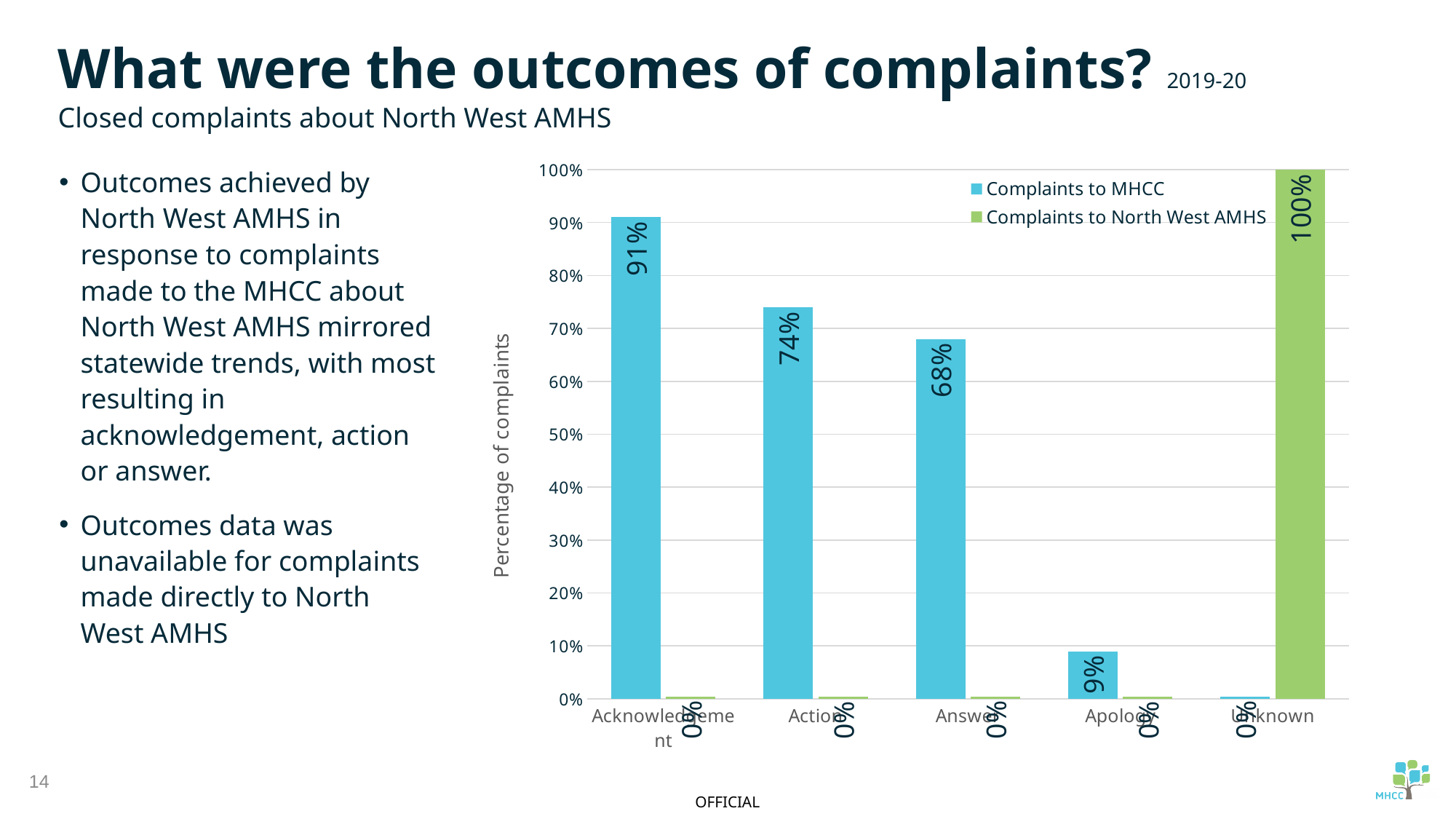
What percentage of complaints to MHCC resulted in Answer? 68% How many outcome categories are shown on the x axis? 5 How many series does the legend list? 2 For Complaints to MHCC, which is larger: Answer or Apology? Answer Which outcome category has the highest value for Complaints to MHCC? Acknowledgement What percentage of complaints to MHCC resulted in Apology? 9% What is the difference between the Acknowledgement and Action percentages for Complaints to MHCC? 17% What type of chart is shown on the slide? Bar chart What percentage of complaints to MHCC resulted in Acknowledgement? 91% What percentage of complaints to MHCC resulted in Action? 74% What percentage of complaints to North West AMHS have an Unknown outcome? 100% Which outcome category has the lowest value for Complaints to MHCC? Unknown